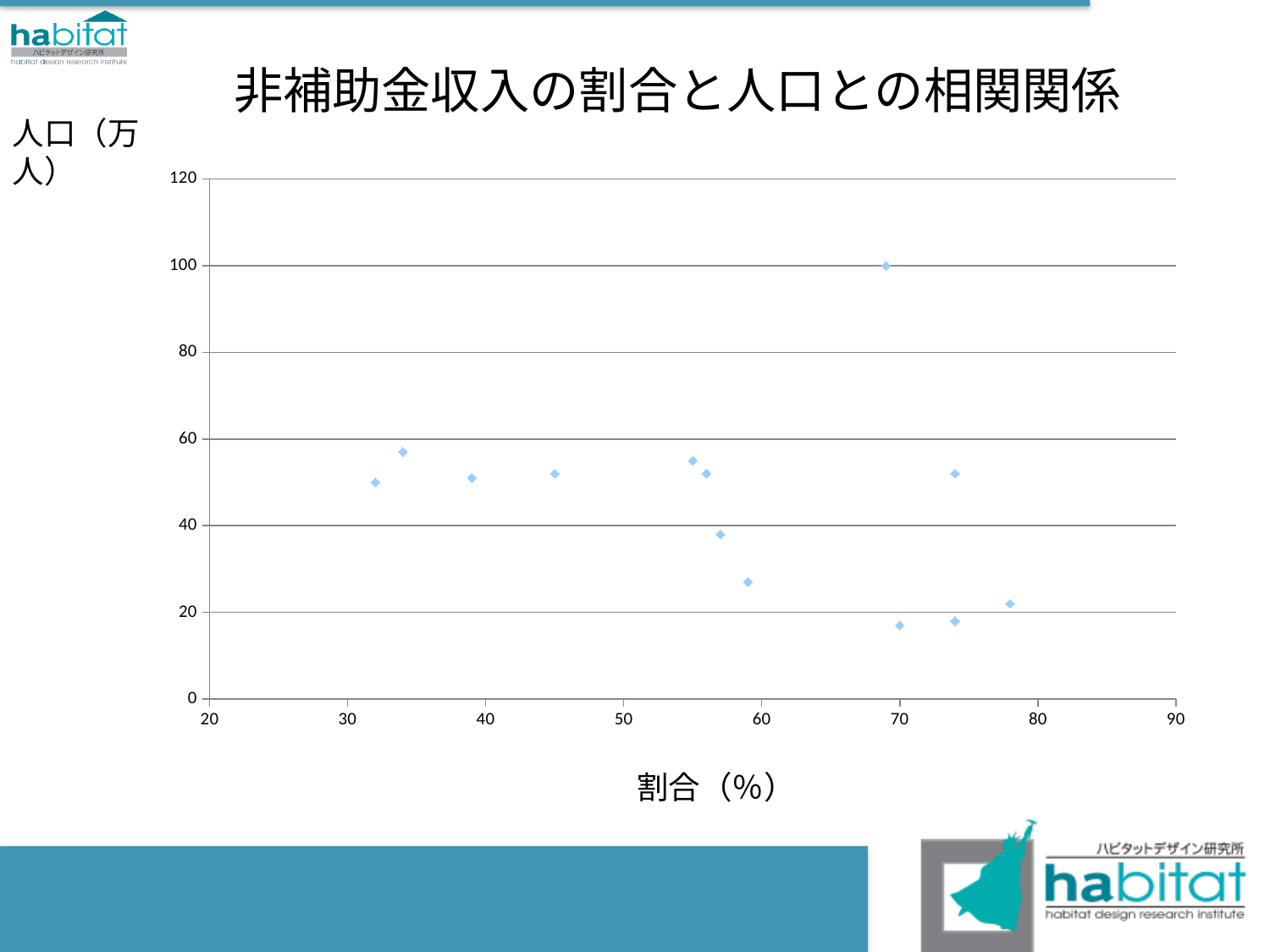
What is the maximum value shown on the y axis? 120 Is the population value of the lowest point on the chart greater or less than 20? less Is the population value of the point plotted near 59% greater or less than 40? less How many data points are plotted on the chart? 13 Is the population value of the highest point on the chart greater or less than 80? greater What is the label of the x axis? 割合（%） What is the title of the chart? 非補助金収入の割合と人口との相関関係 Which has the larger population value: the point plotted near 69% or the point plotted near 70%? the point near 69% What kind of chart is shown on the slide? scatter chart